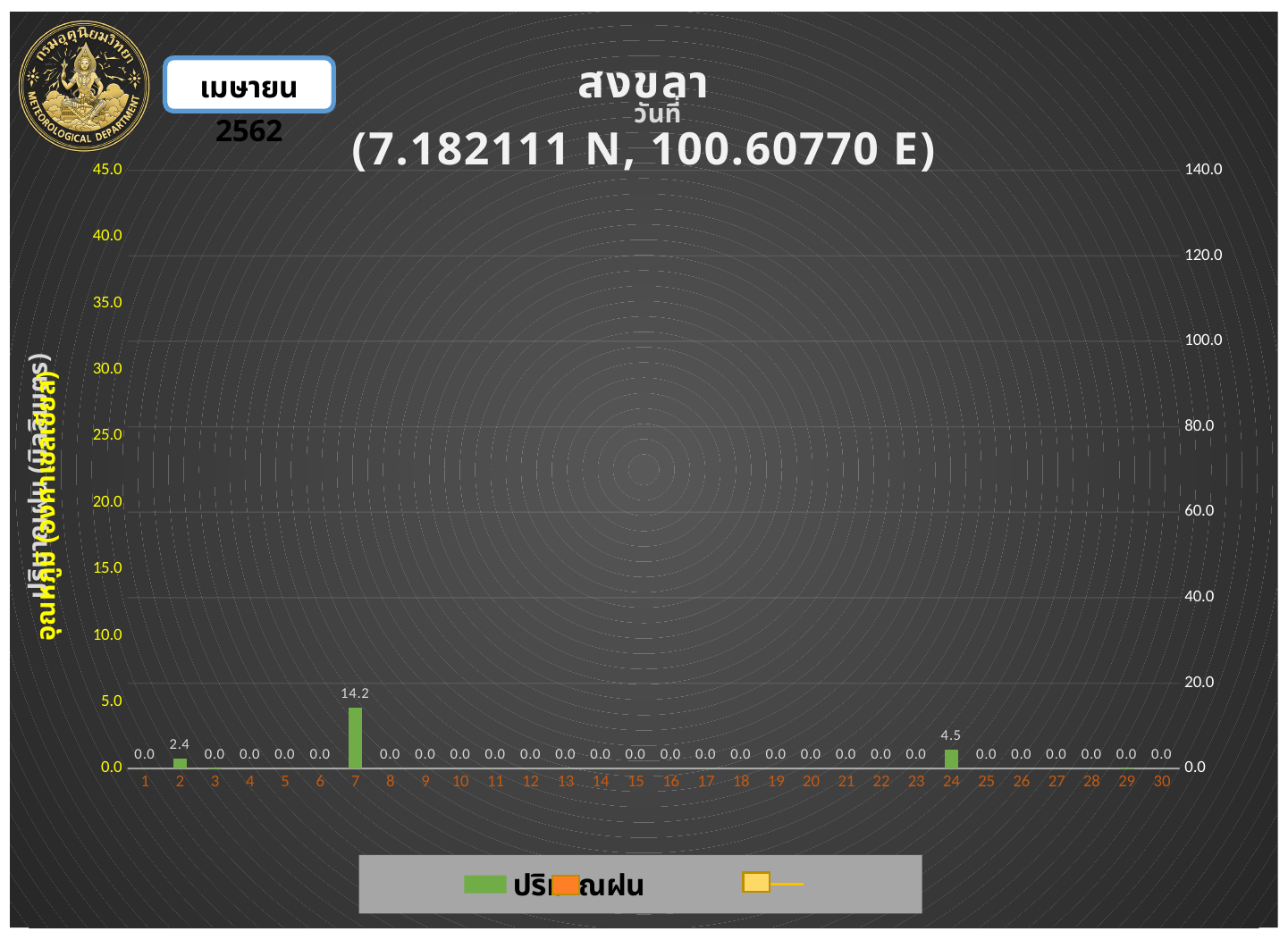
How many days are shown on the x axis? 30 What is the station name given in the chart title? สงขลา Which is larger, the rainfall value for day 2 or for day 24? day 24 What is the difference between the rainfall values for day 24 and day 2? 2.1 What kind of chart is used to show the rainfall values? bar chart What is the rainfall value shown for day 2? 2.4 What is the rainfall value shown for day 7? 14.2 Is the rainfall value for day 7 greater or less than 20.0 on the right axis? less What is the rainfall value shown for day 15? 0.0 What is the difference between the rainfall values for day 7 and day 24? 9.7 Which day has the highest rainfall value? 7 What is the rainfall value shown for day 24? 4.5